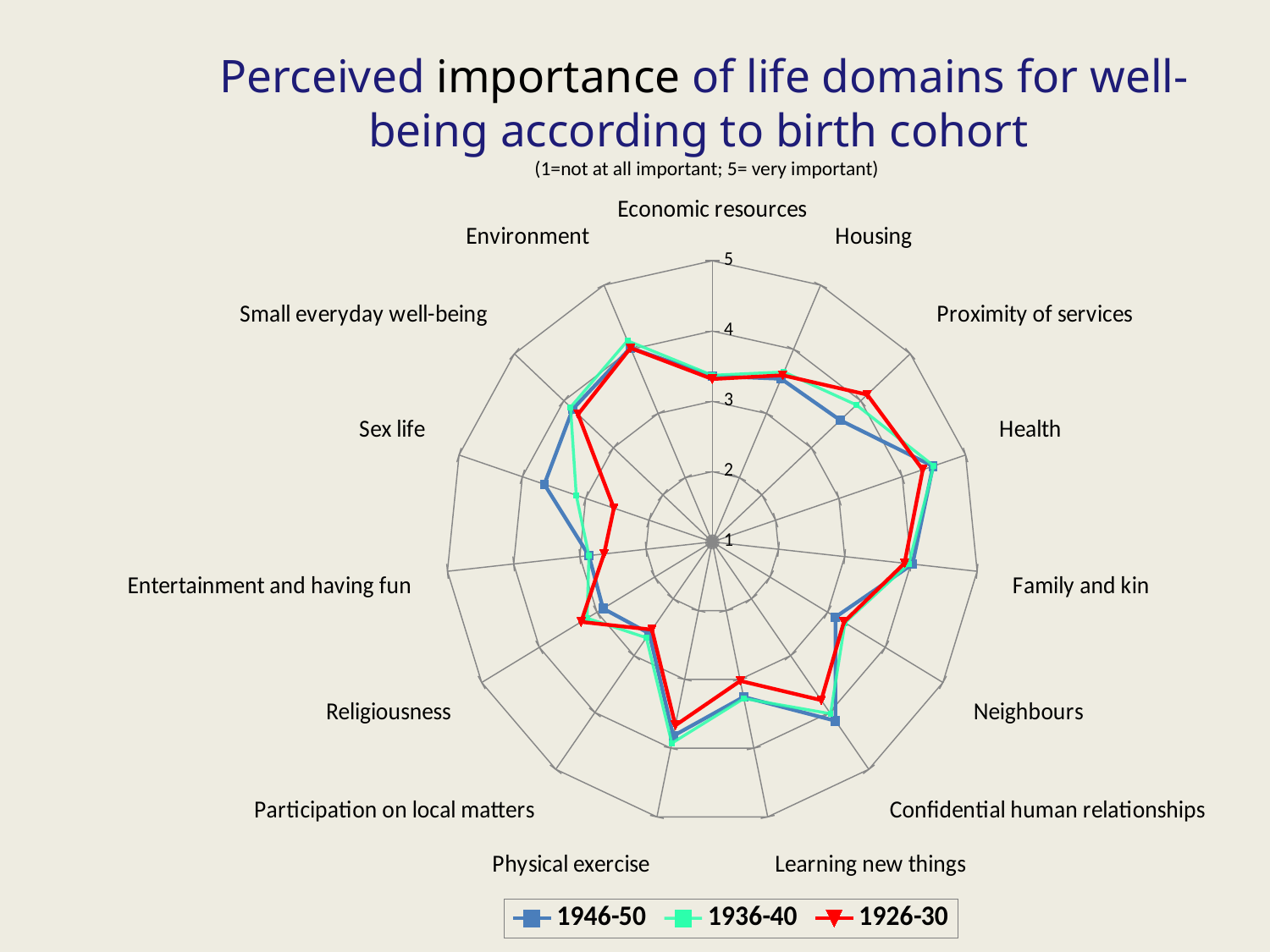
Is the value for Participation on local matters for the 1926-30 cohort greater or less than 3? less Is the value for Sex life for the 1946-50 cohort greater or less than 3? greater For Sex life, which cohort has the higher value, 1946-50 or 1926-30? 1946-50 Is the value for Sex life for the 1926-30 cohort greater or less than 3? less What kind of chart is shown on the slide? Radar chart How many life domains (categories) are plotted on the chart? 15 How many birth cohorts (series) does the legend list? 3 For Proximity of services, which cohort has the higher value, 1946-50 or 1926-30? 1926-30 What is the maximum value on the chart's scale? 5 Which birth cohorts are listed in the legend? 1946-50, 1936-40, 1926-30